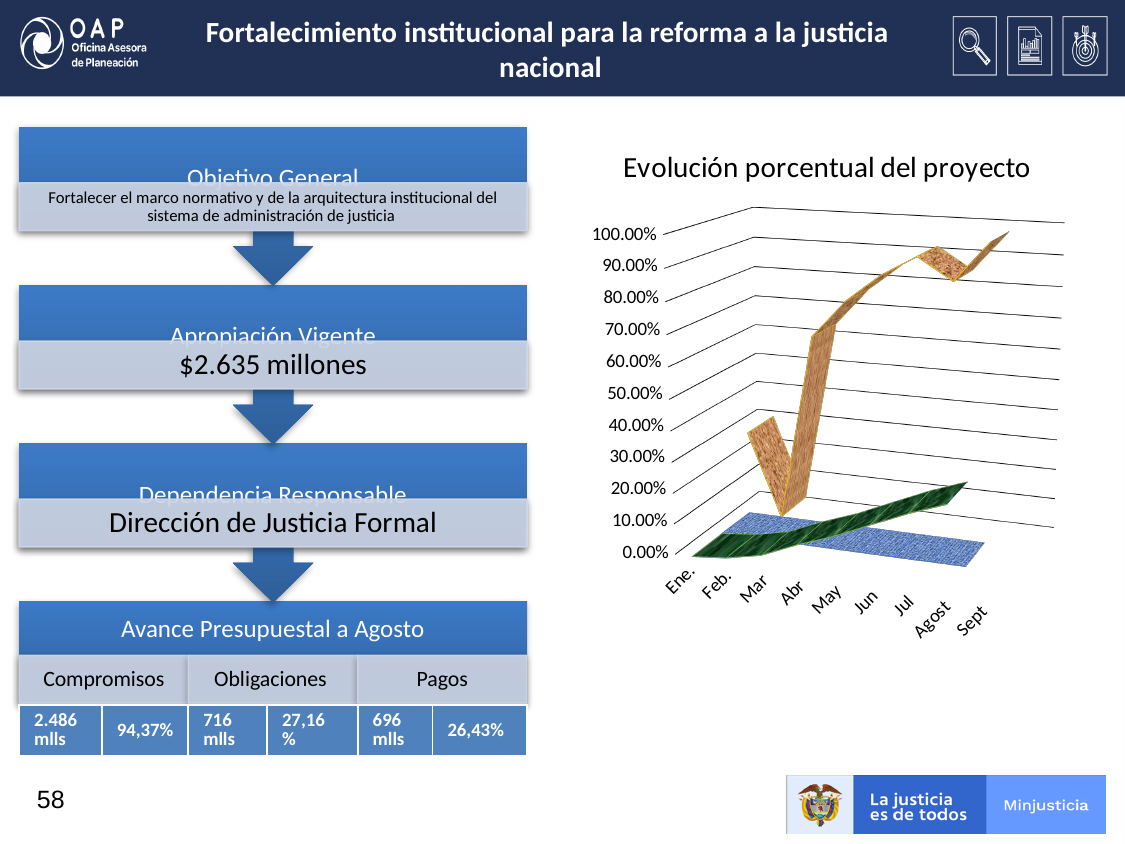
What is the first category on the x axis of the chart? Ene. Does the green series rise or fall from Ene. to Sept? rise What is the title of the chart on the slide? Evolución porcentual del proyecto How many months are shown on the x axis of the chart? 9 What is the last category on the x axis of the chart? Sept What kind of chart is shown on the slide? 3D line chart Is the value of the green series at Ene. greater or less than 50.00%? less What is the highest tick value shown on the vertical axis of the chart? 100.00%